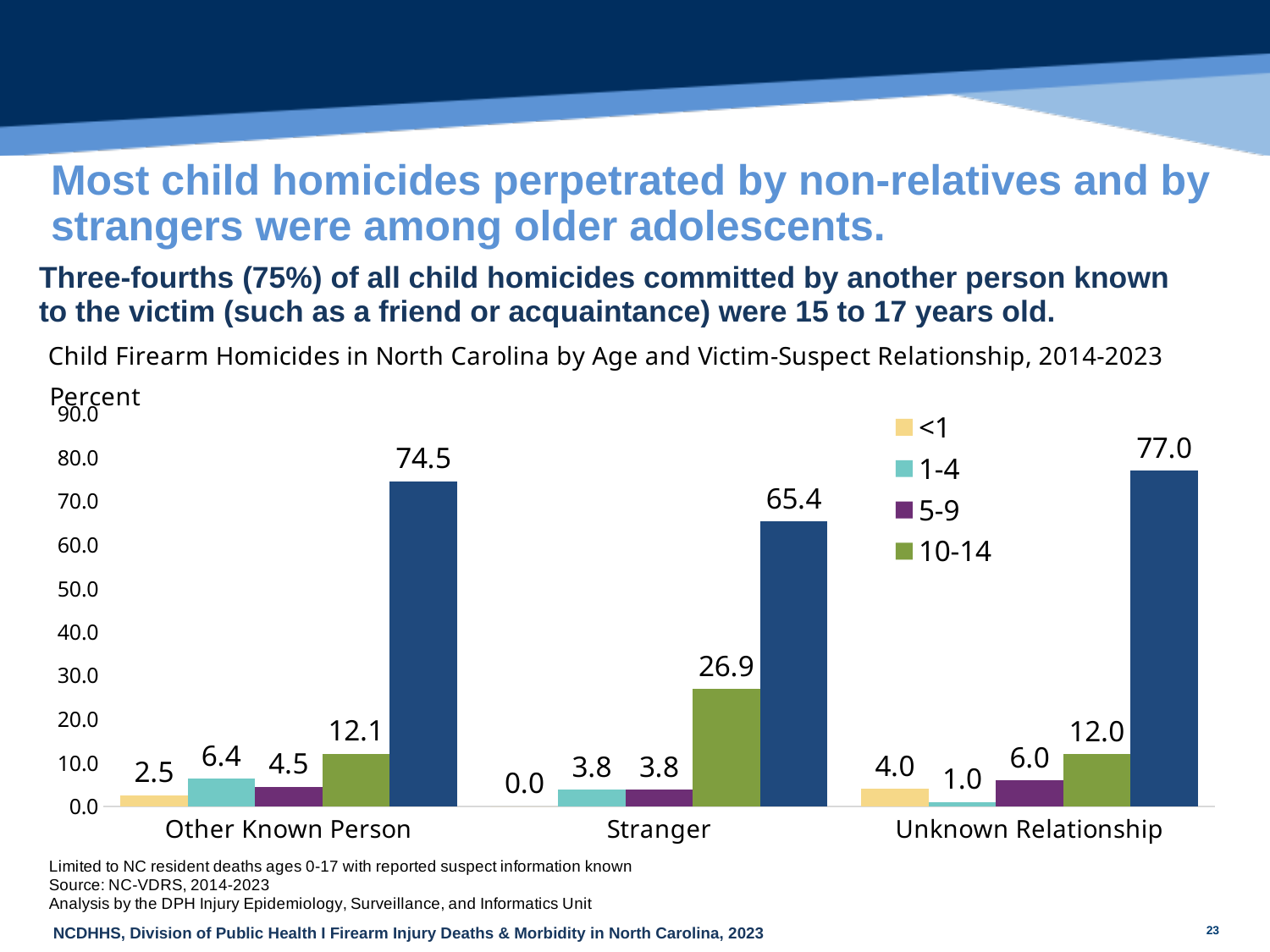
What is the value for the 10-14 age group in the Stranger category? 26.9 Is the value of the tallest bar in the Stranger category greater or less than 70.0? less Which category has the highest value for the 10-14 age group? Stranger In the Other Known Person category, which is larger: the 1-4 value or the 5-9 value? 1-4 What is the value of the tallest bar in the Unknown Relationship category? 77.0 Which category has the lowest value for the <1 age group? Stranger How many series does the legend list? 4 How many victim-suspect relationship categories are shown on the x axis? 3 What kind of chart is shown on the slide? Bar chart What is the difference between the 10-14 values for Stranger and Other Known Person? 14.8 What is the value for the <1 age group in the Other Known Person category? 2.5 What is the value for the 1-4 age group in the Unknown Relationship category? 1.0